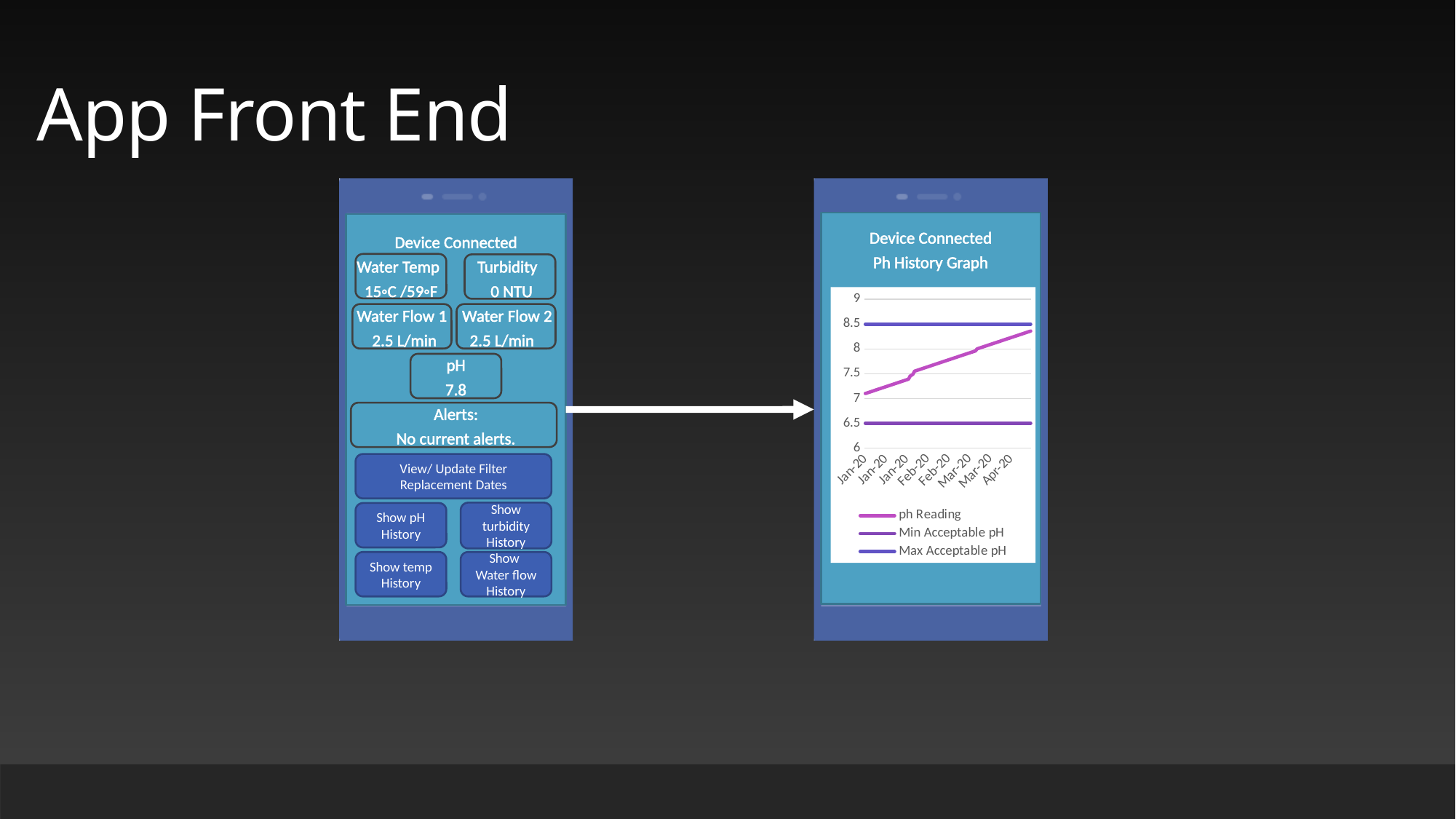
What is the difference between the Max Acceptable pH and the Min Acceptable pH lines? 2 What kind of chart is shown on the Ph History Graph screen? line chart Does the ph Reading line rise or fall from Jan-20 to Apr-20? rise Is the ph Reading at Apr-20 above or below the Max Acceptable pH line? below What is the title of the graph shown on the right-hand phone screen? Ph History Graph How many series does the legend of the Ph History Graph list? 3 What value does the Max Acceptable pH line sit at? 8.5 What value does the Min Acceptable pH line sit at? 6.5 Which is larger, the Max Acceptable pH line or the Min Acceptable pH line? Max Acceptable pH Is the ph Reading at the first Jan-20 point greater or less than 7.5? less Is the ph Reading at Apr-20 greater or less than 8? greater